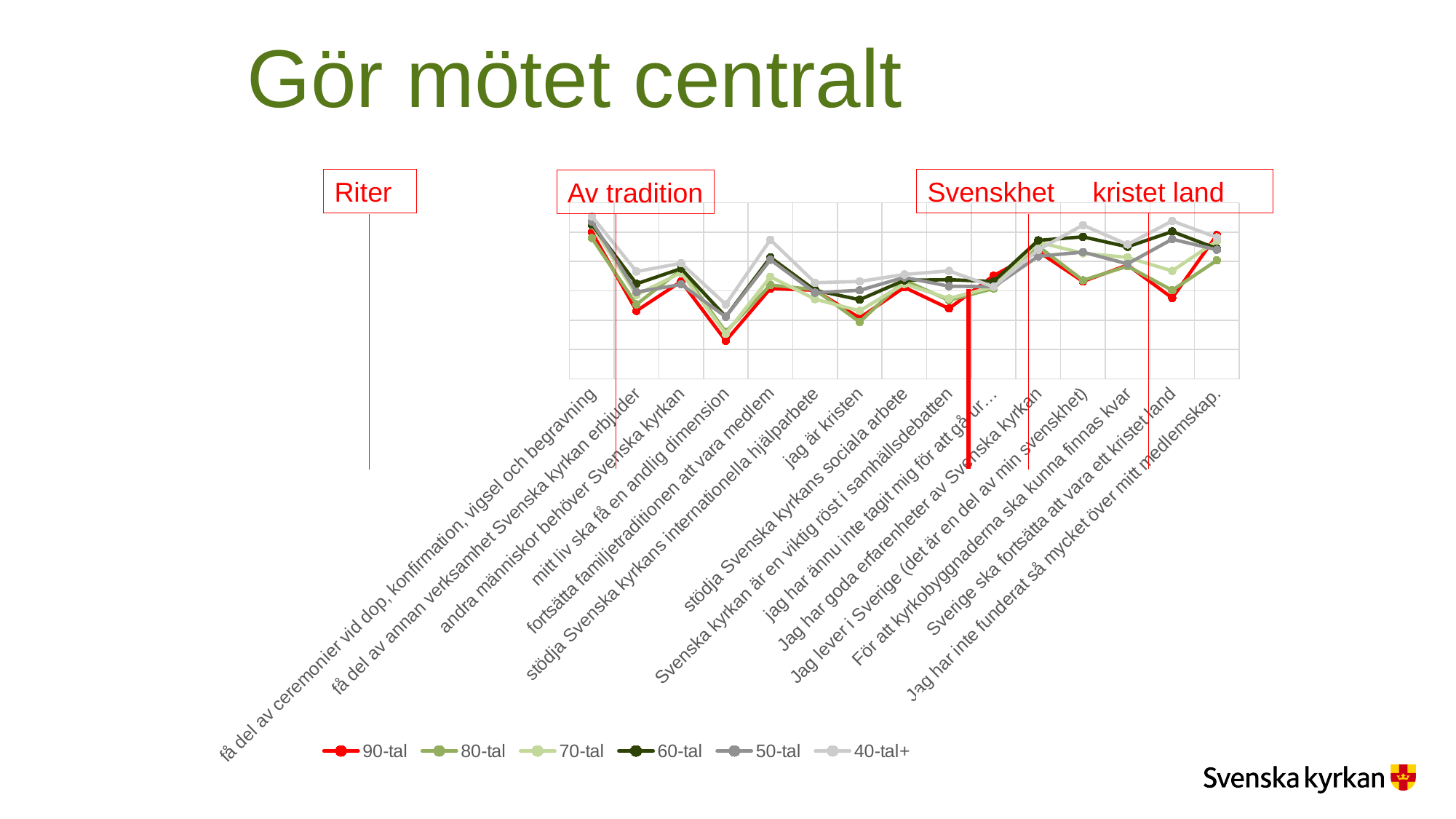
How many series does the legend list? 6 How many categories are plotted along the x axis? 15 For the 90-tal series, which category has the lowest value? mitt liv ska få en andlig dimension At the category 'mitt liv ska få en andlig dimension', which series has the lowest value? 90-tal Which series is drawn in red? 90-tal What kind of chart is shown on the slide? line chart What is the title of the slide? Gör mötet centralt At the category 'Sverige ska fortsätta att vara ett kristet land', which is higher: 60-tal or 90-tal? 60-tal Do the series rise or fall from 'jag har ännu inte tagit mig för att gå ur…' to 'Jag har goda erfarenheter av Svenska kyrkan'? rise For the 40-tal+ series, which category has the lowest value? mitt liv ska få en andlig dimension For the 90-tal series, which category has the highest value? få del av ceremonier vid dop, konfirmation, vigsel och begravning At the category 'mitt liv ska få en andlig dimension', which is higher: 40-tal+ or 90-tal? 40-tal+